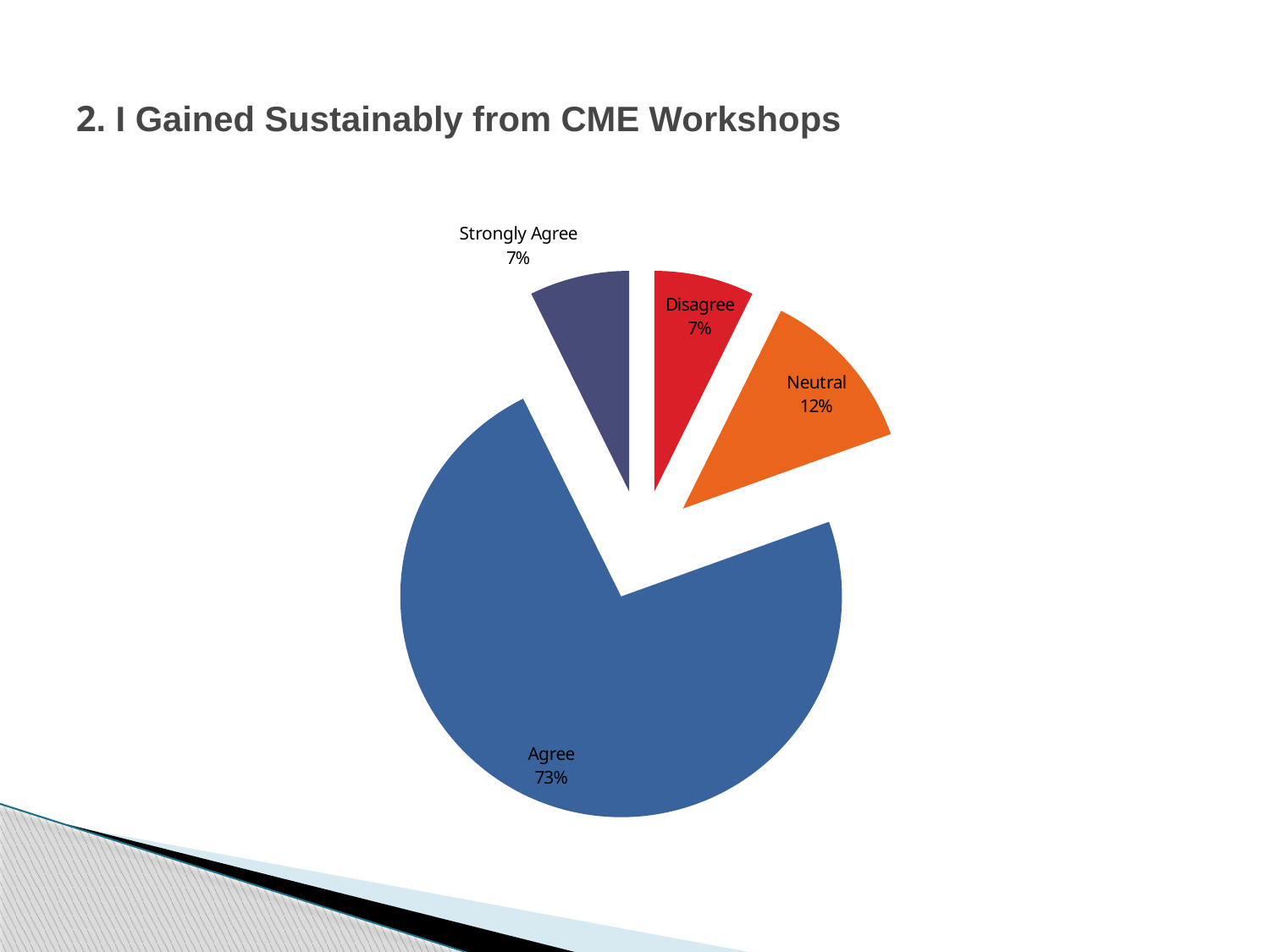
What is the combined share of Agree and Strongly Agree? 80% What is the difference in percentage points between Neutral and Disagree? 5 What is the difference in percentage points between Agree and Neutral? 61 What percentage of respondents chose Disagree? 7% What kind of chart is shown on the slide? pie chart How many slices does the pie chart have? 4 Which response category has the largest share of the pie? Agree Which is larger, the share for Neutral or the share for Strongly Agree? Neutral What percentage of respondents chose Strongly Agree? 7% What is the title of the slide containing the pie chart? 2. I Gained Sustainably from CME Workshops What percentage of respondents chose Agree? 73% What percentage of respondents chose Neutral? 12%